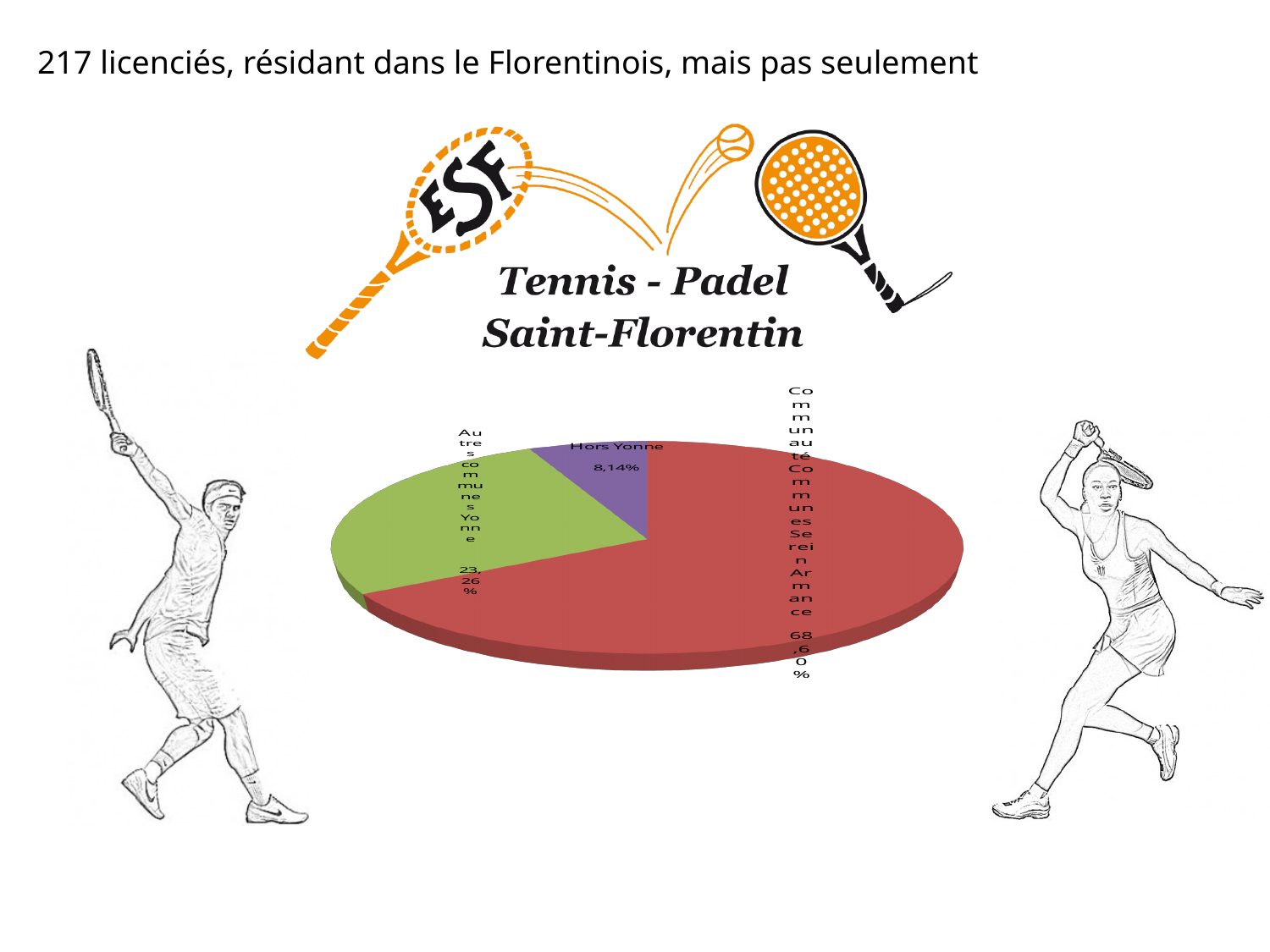
How many slices does the pie chart have? 3 What kind of chart is shown on the slide? pie chart What share of the pie does the Autres communes Yonne slice represent? 23,26% Which is larger, the Autres communes Yonne slice or the Hors Yonne slice? Autres communes Yonne What colour is the Hors Yonne slice of the pie chart? purple What share of the pie does the Hors Yonne slice represent? 8,14% What is the difference in percentage points between the Autres communes Yonne slice and the Hors Yonne slice? 15,12 What is the difference in percentage points between the Communauté Communes Serein Armance slice and the Autres communes Yonne slice? 45,34 What colour is the Autres communes Yonne slice of the pie chart? green What share of the pie does the Communauté Communes Serein Armance slice represent? 68,60% Which slice of the pie chart is the largest? Communauté Communes Serein Armance Which slice of the pie chart is the smallest? Hors Yonne